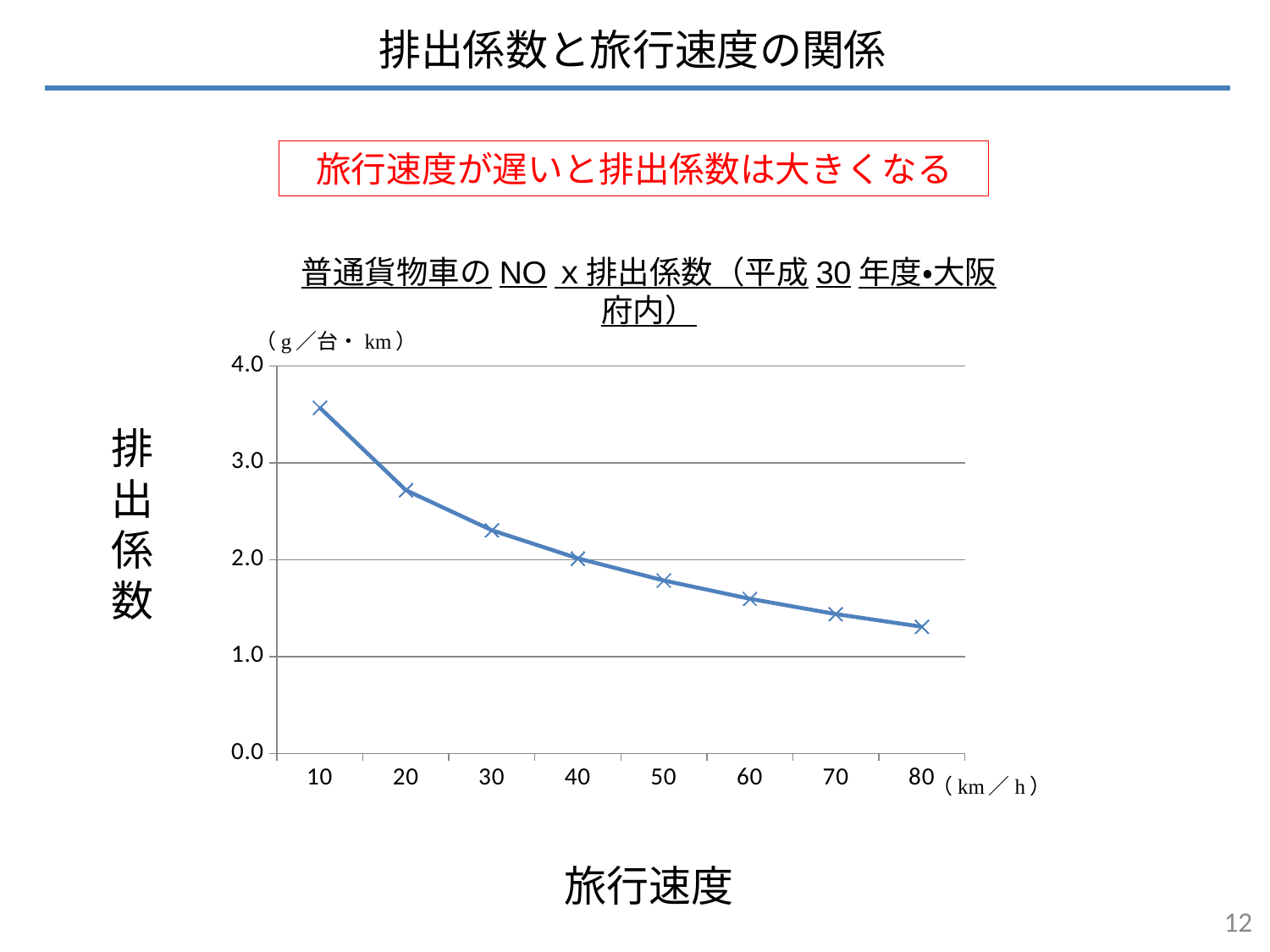
Is the emission factor at 50 km/h greater or less than 2.0? less Which has the larger emission factor, 20 km/h or 60 km/h? 20 km/h Do the emission factor values rise or fall as travel speed increases along the x axis? fall What unit is shown for the y axis of the chart? g／台・km At which travel speed is the NOx emission factor lowest? 80 km/h Is the emission factor at 20 km/h greater or less than 3.0? less At which travel speed is the NOx emission factor highest? 10 km/h How many data points are plotted on the line? 8 Is the emission factor at 30 km/h greater or less than 2.0? greater What kind of chart is shown on the slide? line chart